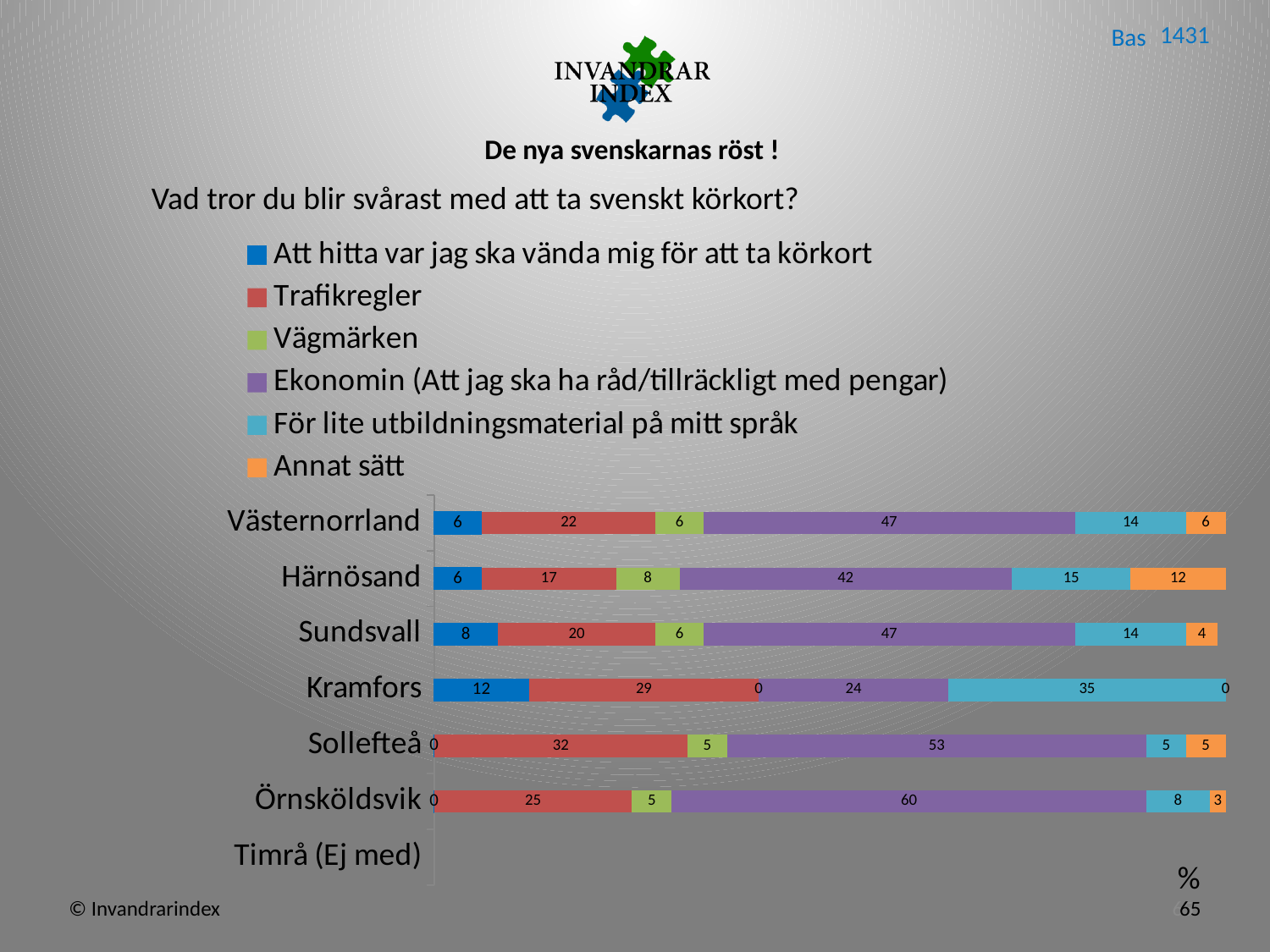
Which is larger, the Att hitta var jag ska vända mig för att ta körkort value for Kramfors or for Sundsvall? Kramfors What is the value for Ekonomin (Att jag ska ha råd/tillräckligt med pengar) for Örnsköldsvik? 60 What is the value for För lite utbildningsmaterial på mitt språk for Kramfors? 35 What is the difference between the Trafikregler values for Sollefteå and Härnösand? 15 Which category on the axis has no bar plotted? Timrå (Ej med) Which category has the lowest value for Ekonomin (Att jag ska ha råd/tillräckligt med pengar)? Kramfors What is the total of the stacked bar for Västernorrland? 101 How many series does the legend list? 6 What is the value for Annat sätt for Härnösand? 12 What kind of chart is shown on the slide? stacked bar chart Which category has the highest value for Ekonomin (Att jag ska ha råd/tillräckligt med pengar)? Örnsköldsvik What is the value for Trafikregler for Sollefteå? 32